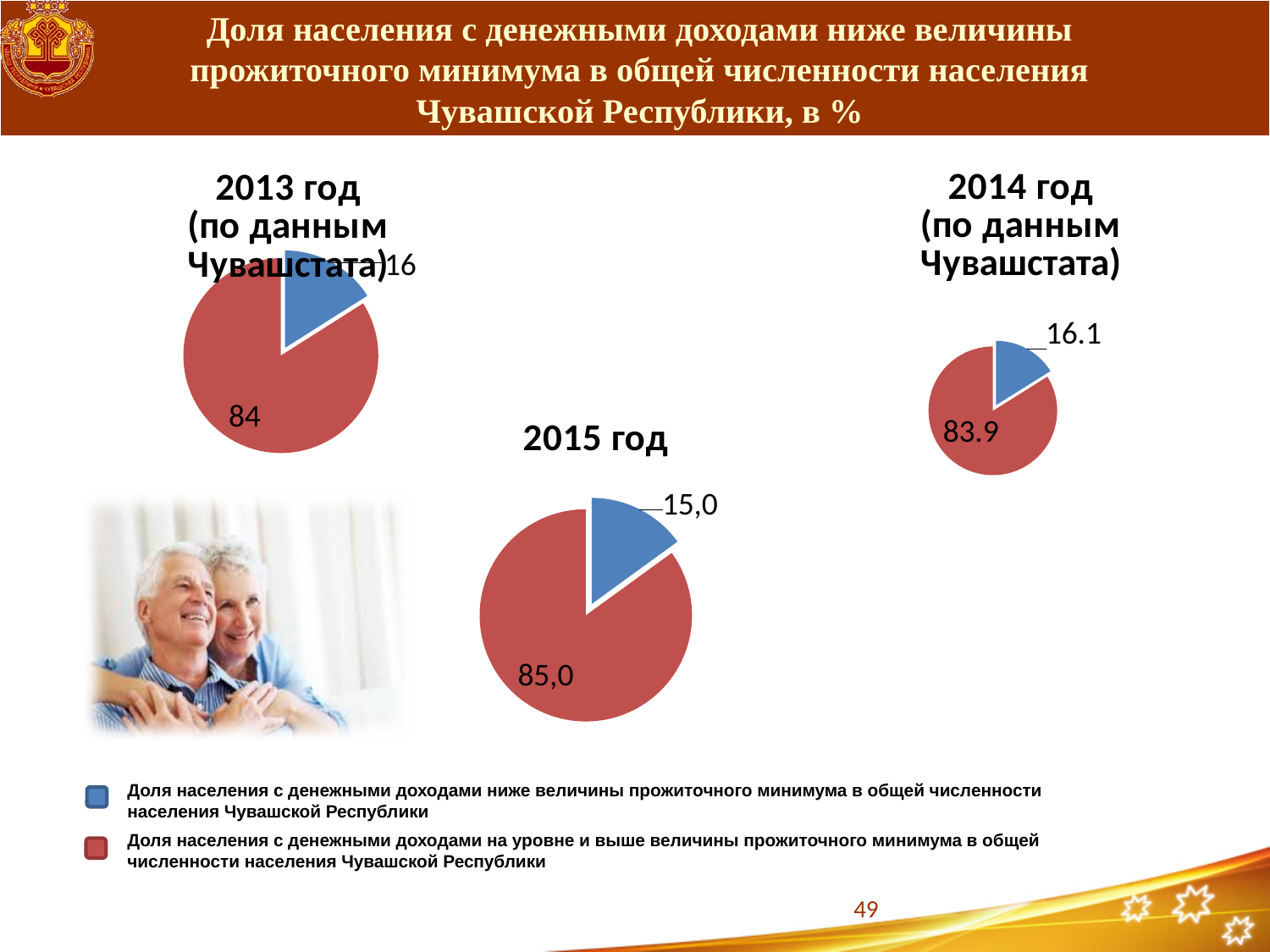
In the 2015 год pie chart, what is the difference between the red slice and the blue slice? 70,0 How many pie charts are shown on the slide? 3 In the 2013 год pie chart, what is the value of the red slice (share with incomes at or above the subsistence minimum)? 84 In the 2015 год pie chart, what is the value of the blue slice? 15,0 Which colour in the legend represents the share of population with incomes below the subsistence minimum? blue In the 2014 год pie chart, what is the value of the blue slice? 16.1 In the 2014 год pie chart, what is the value of the red slice? 83.9 In the 2013 год pie chart, what is the value of the blue slice (share of population with incomes below the subsistence minimum)? 16 Which year's pie chart has the largest blue slice (share below the subsistence minimum): 2013, 2014 or 2015? 2014 год What kind of chart is used for the 2013 год data? pie chart In the 2015 год pie chart, what is the value of the red slice? 85,0 How many slices does each pie chart have? 2